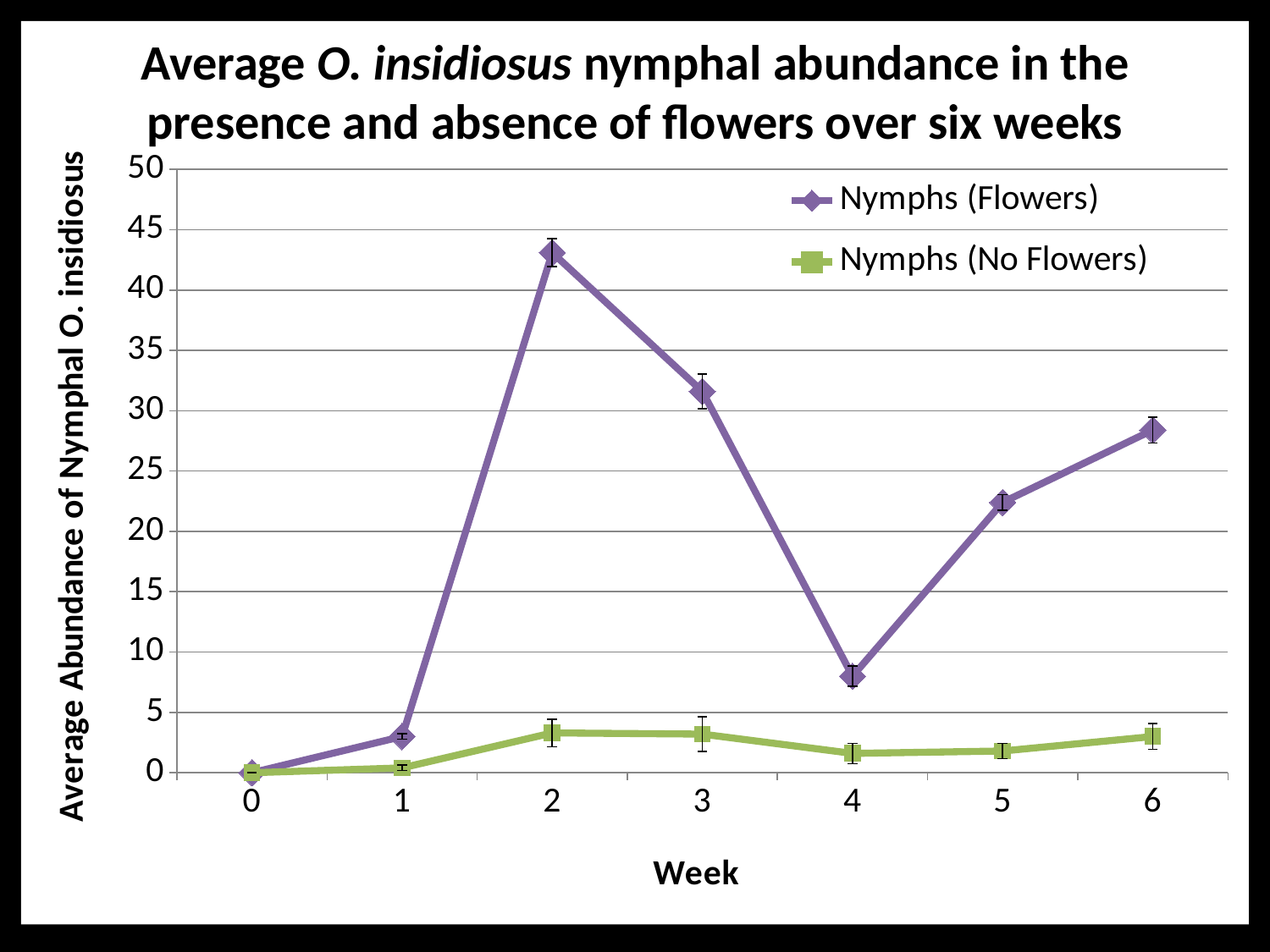
How many series does the legend list? 2 What is the label of the x axis? Week What kind of chart is shown on the slide? line chart Is the value for Nymphs (Flowers) at week 4 greater or less than 10? less At which week does the Nymphs (Flowers) series reach its highest value? Week 2 Is the value for Nymphs (Flowers) at week 2 greater or less than 40? greater Does the Nymphs (Flowers) series rise or fall from week 4 to week 6? rise At which week is the Nymphs (Flowers) series at its lowest value? Week 0 How many weeks (data points) are plotted along the x axis for each series? 7 Is the value for Nymphs (No Flowers) at week 2 greater or less than 5? less At week 3, which series has the larger value, Nymphs (Flowers) or Nymphs (No Flowers)? Nymphs (Flowers)